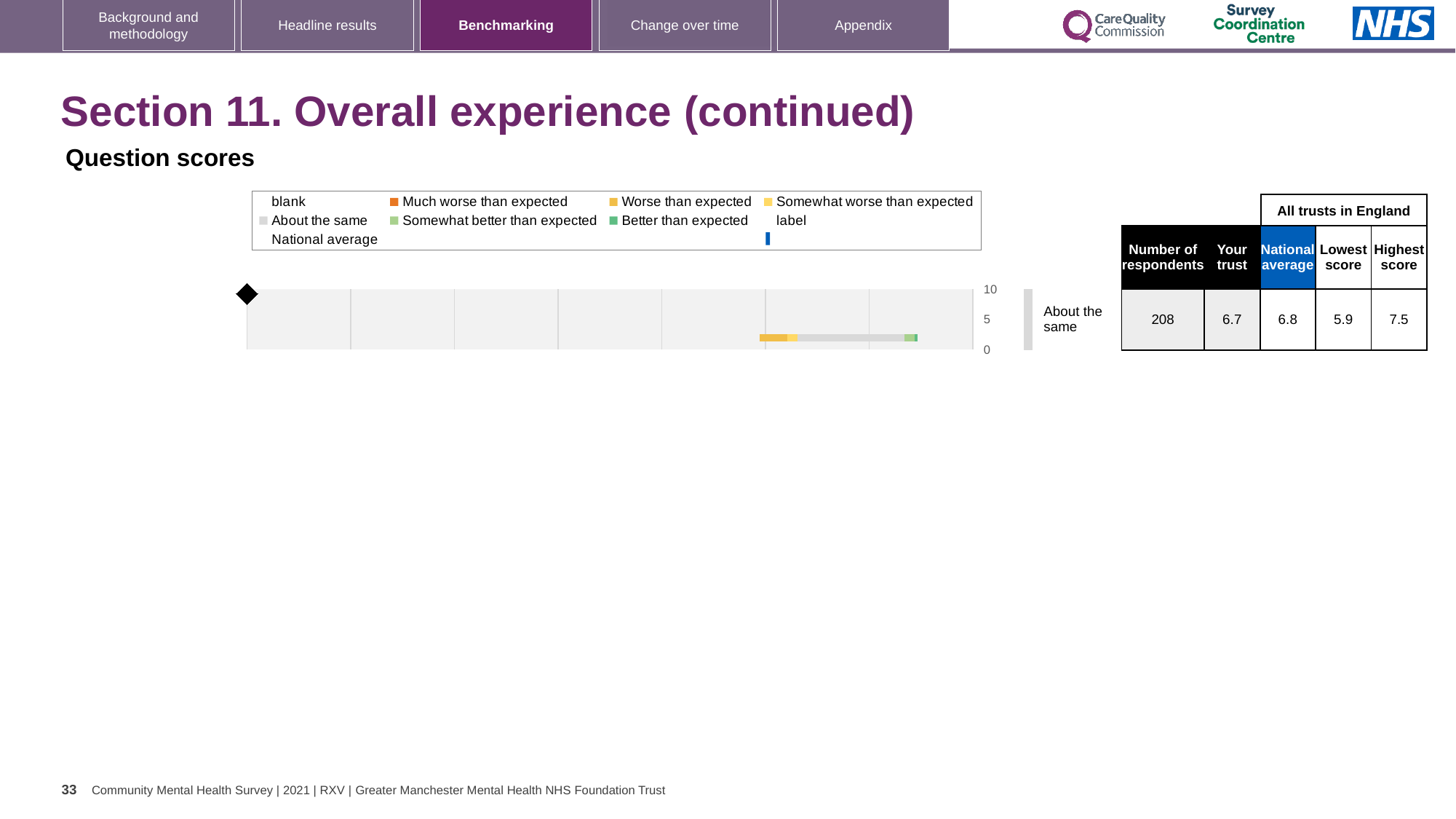
What kind of chart is shown under 'Question scores'? bar chart What is the difference between the Highest score and the Lowest score for the question row shown? 1.6 How many respondents are recorded for the question row shown in the Question scores chart? 208 What is the maximum value shown on the axis of the Question scores chart? 10 What is the 'Your trust' score for the question row shown in the Question scores chart? 6.7 Which is larger for the question row shown: the 'Your trust' score or the National average? National average How many question rows (bars) are plotted in the Question scores chart? 1 How many entries does the legend of the Question scores chart list? 9 What benchmark category label is given to the bar in the Question scores chart? About the same What is the National average score for the question row shown in the Question scores chart? 6.8 What is the Lowest score across all trusts in England for the question row shown? 5.9 What is the Highest score across all trusts in England for the question row shown? 7.5